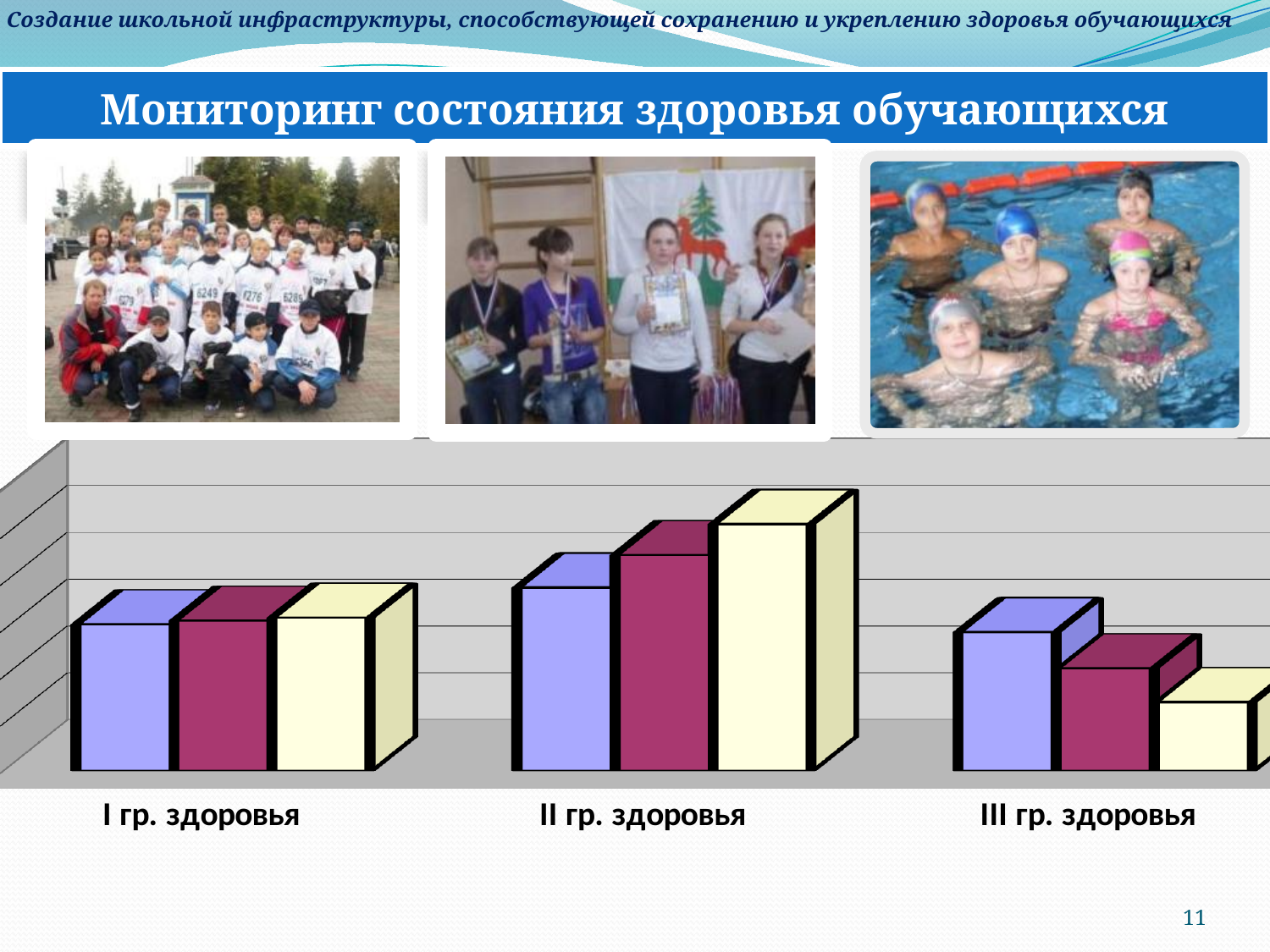
How many categories are shown on the x axis of the chart? 3 Within the category III гр. здоровья, do the bars rise or fall from left to right? fall For the magenta bars, which category has the highest value? II гр. здоровья For the yellow bars, which category has the lowest value? III гр. здоровья In the category II гр. здоровья, which is larger: the blue bar or the yellow bar? the yellow bar Which category has the tallest bars in the chart? II гр. здоровья Within the category II гр. здоровья, do the bars rise or fall from left to right? rise What kind of chart is shown on the slide? bar chart For the blue bars, which category has the highest value? II гр. здоровья In the category III гр. здоровья, which is larger: the blue bar or the yellow bar? the blue bar What is the label of the middle category on the x axis of the chart? II гр. здоровья How many bars are plotted for each category in the chart? 3